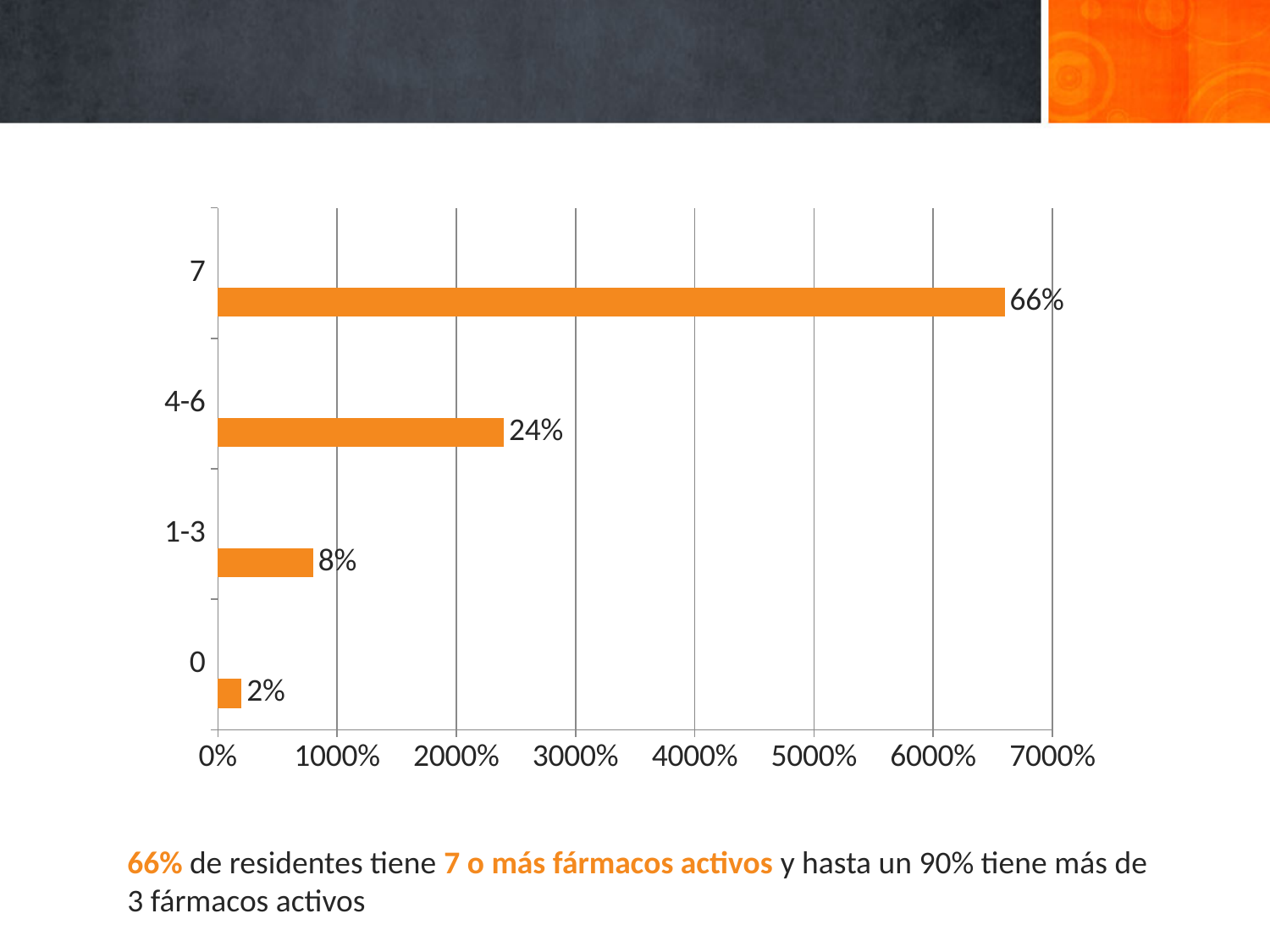
Which category has the lowest value? 0 Which is larger, the value for 4-6 or the value for 1-3? 4-6 What is the value for the category 0? 2% Which category has the highest value? 7 What is the value for the category 7? 66% What is the value for the category 1-3? 8% What kind of chart is shown on the slide? bar chart What is the value for the category 4-6? 24% What colour are the bars in the chart? orange How many categories are shown in the chart? 4 What is the difference between the values for 1-3 and 0? 6% What is the difference between the values for 7 and 4-6? 42%